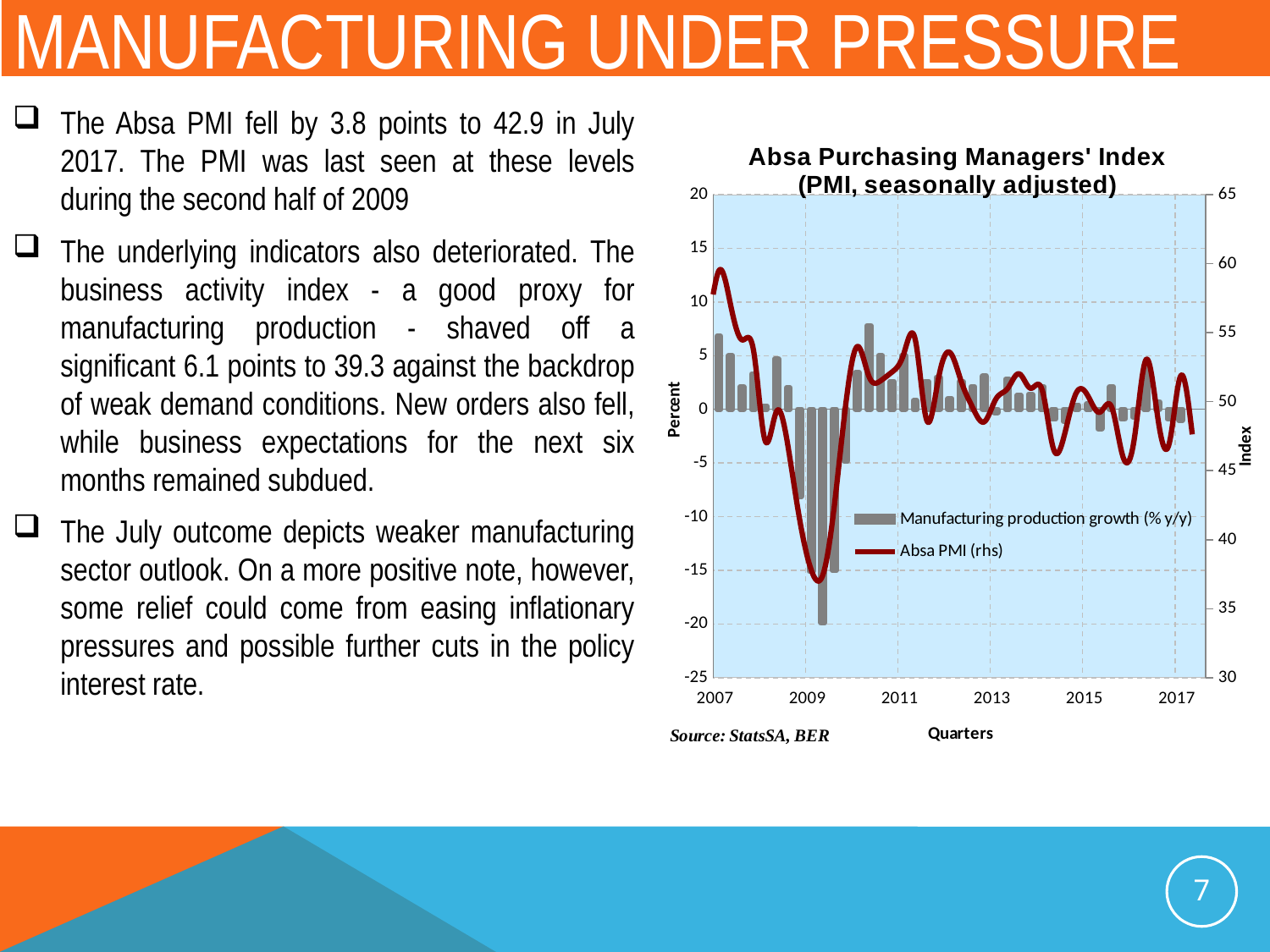
What is the title of the chart? Absa Purchasing Managers' Index (PMI, seasonally adjusted) What is the label of the x axis of the chart? Quarters What kind of chart is shown on the slide? A combined bar and line chart Around which year does the Absa PMI line reach its highest point? 2007 Does the Absa PMI line rise or fall between 2007 and 2009? fall Is the lowest value of the Absa PMI line in 2009 greater or less than 40 on the right-hand axis? less Is the peak value of the Absa PMI line in 2007 greater or less than 55 on the right-hand axis? greater Which series is plotted as bars in the chart? Manufacturing production growth (% y/y) How many series does the chart legend list? 2 Around which year does the Absa PMI line reach its lowest point? 2009 In which year does the manufacturing production growth series reach its lowest bar? 2009 Is the lowest manufacturing production growth bar (in 2009) greater or less than -15? less